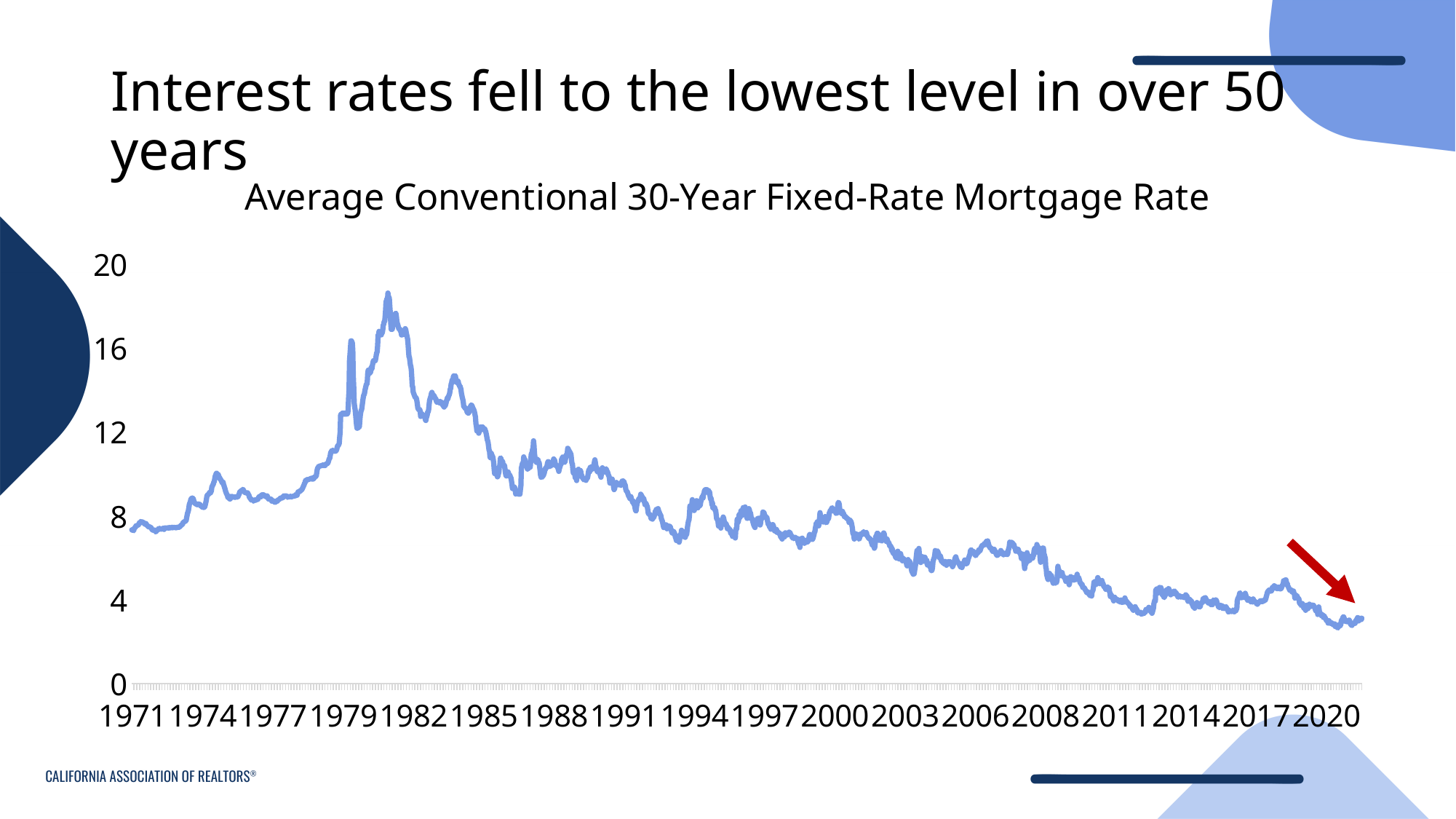
Is the mortgage rate at the end of the series in 2020 greater or less than 4? less Is the mortgage rate in 2006 greater or less than 4? greater How many year labels are shown along the x axis? 18 Is the peak value of the mortgage rate greater or less than 16? greater What is the highest value shown on the vertical axis? 20 What is the title of the chart? Average Conventional 30-Year Fixed-Rate Mortgage Rate Which is larger, the mortgage rate in 1982 or the mortgage rate in 2020? 1982 Overall, do the mortgage rates rise or fall from 1982 to 2020? fall What kind of chart is shown on the slide? line chart